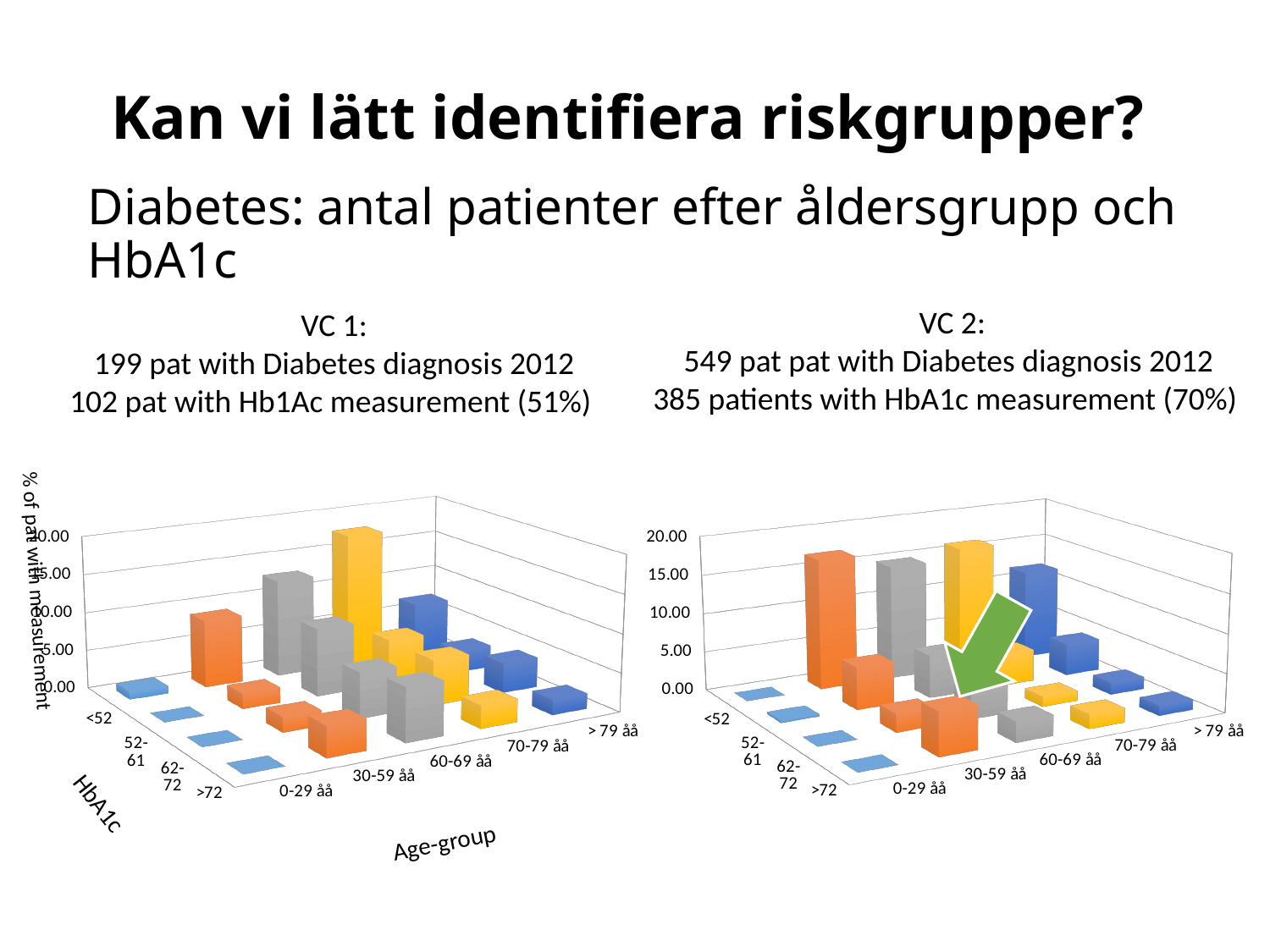
How many age-group categories are shown along the Age-group axis of the VC 1 chart? 5 How many HbA1c categories are shown on the VC 2 chart? 4 In the VC 2 chart, is the value for 30-59 åå at HbA1c <52 greater or less than 10.00? greater In the VC 1 chart, is the value for 70-79 åå at HbA1c <52 greater or less than 10.00? greater In the VC 2 chart, is the value for 0-29 åå at HbA1c >72 greater or less than 5.00? less What kind of chart is the VC 1 chart? bar chart What is the title of the vertical axis on the VC 1 chart? % of pat with measurement How many charts are shown on the slide? 2 What is the highest tick value shown on the vertical axis of the VC 2 chart? 20.00